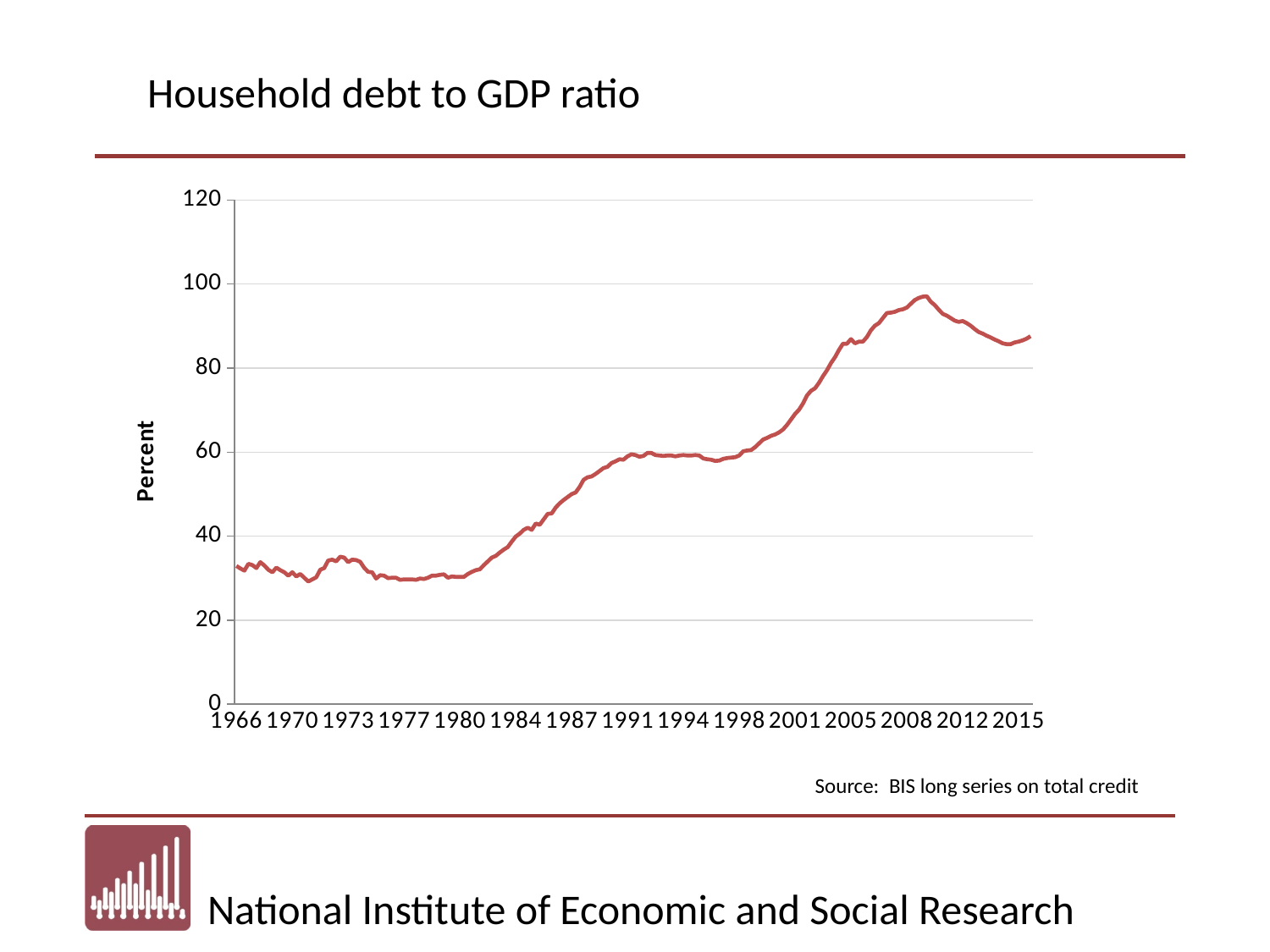
Is the value for 2001 greater or less than 60? greater What is the label on the vertical axis of the chart? Percent What kind of chart is shown on the slide? line chart Is the value for 2008 greater or less than 100? less Does the household debt to GDP ratio rise or fall between 1980 and 1991? rise Is the value for 2005 greater or less than 80? greater Which is larger, the value for 2001 or the value for 1994? 2001 What is the title of the chart? Household debt to GDP ratio